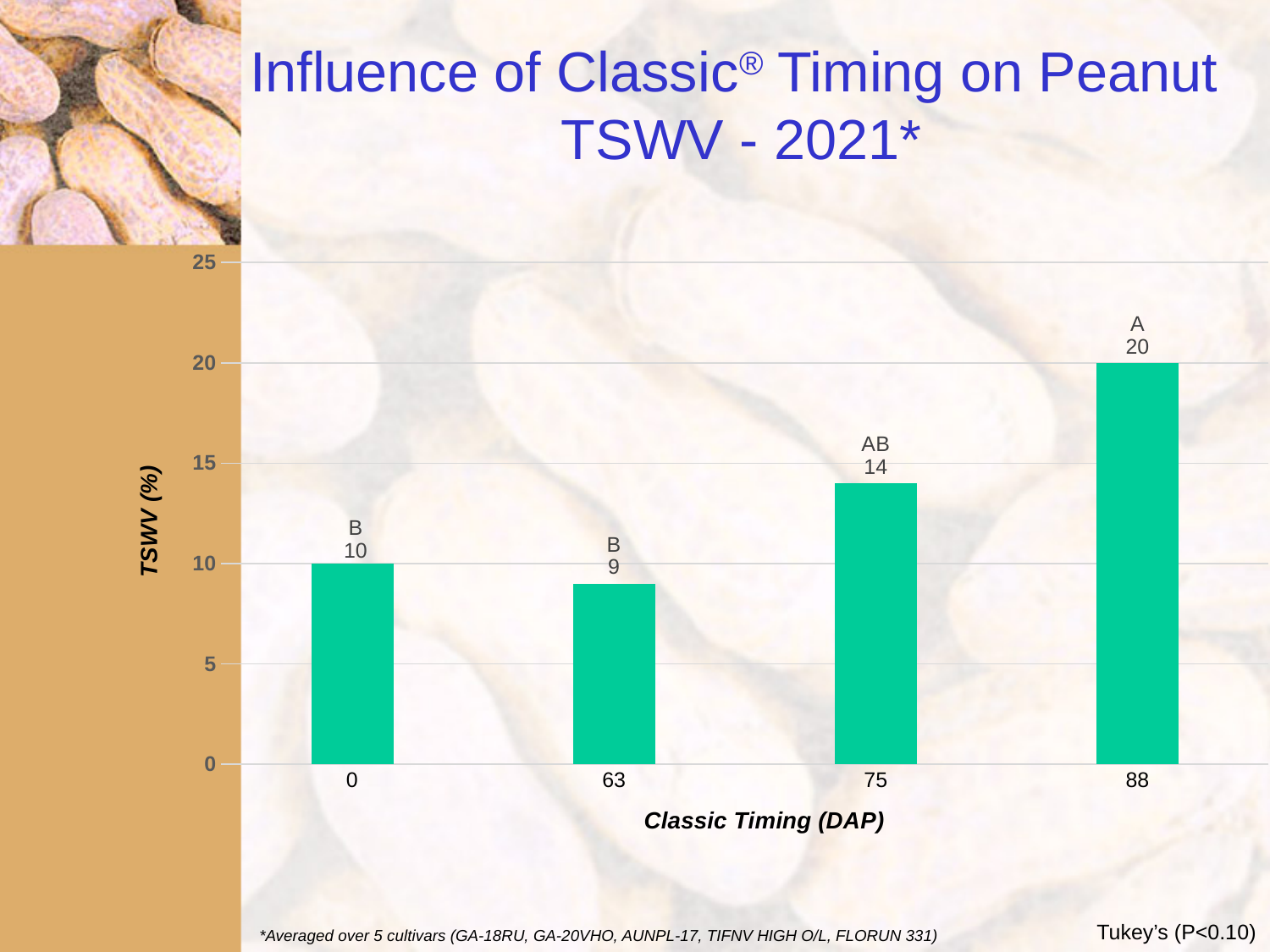
What is the TSWV (%) value for Classic timing of 63 DAP? 9 What is the TSWV (%) value for Classic timing of 75 DAP? 14 Which Classic timing (DAP) has the lowest TSWV (%)? 63 Which has a higher TSWV (%): the 75 DAP timing or the 63 DAP timing? 75 DAP What is the difference in TSWV (%) between the 88 DAP and 0 DAP timings? 10 Which Classic timing (DAP) has the highest TSWV (%)? 88 What is the TSWV (%) value for Classic timing of 88 DAP? 20 What is the label on the y axis of the chart? TSWV (%) What is the TSWV (%) value for Classic timing of 0 DAP? 10 What statistical letter grouping is shown above the 88 DAP bar? A How many Classic timing categories are shown on the x axis? 4 What kind of chart is shown on the slide? Bar chart